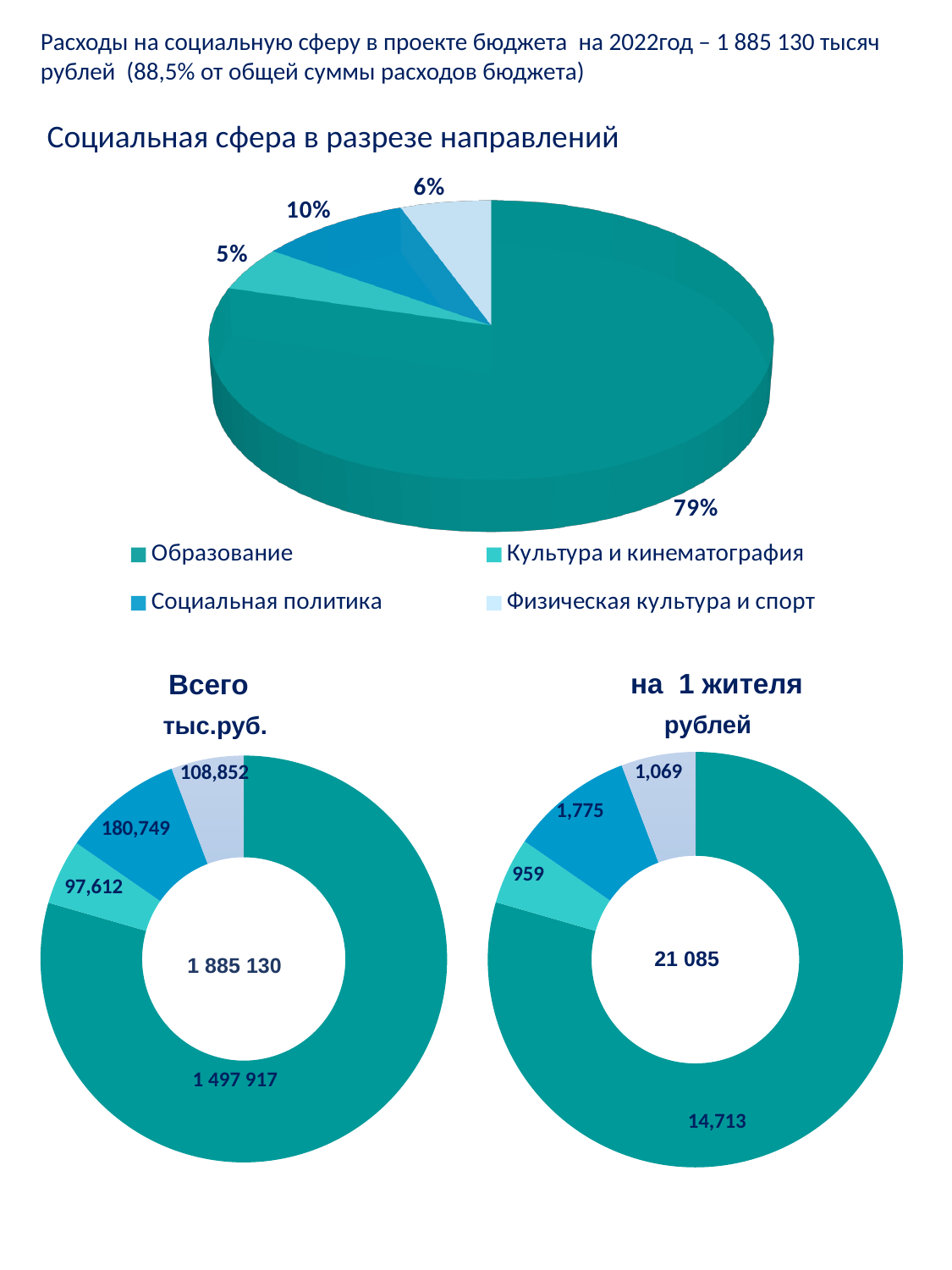
In the donut chart 'Всего тыс.руб.', what is the value of the smallest segment? 97,612 What type of chart is 'Социальная сфера в разрезе направлений'? Pie chart In the pie chart 'Социальная сфера в разрезе направлений', what is the difference in percentage points between Социальная политика and Физическая культура и спорт? 4 percentage points In the donut chart 'на 1 жителя рублей', which is larger: the segment labelled 1,775 or the segment labelled 1,069? 1,775 In the pie chart 'Социальная сфера в разрезе направлений', what share does Образование have? 79% In the donut chart 'на 1 жителя рублей', what total is shown in the centre? 21 085 In the donut chart 'Всего тыс.руб.', what is the value of the largest segment? 1 497 917 How many categories does the legend of the pie chart 'Социальная сфера в разрезе направлений' list? 4 In the pie chart 'Социальная сфера в разрезе направлений', what share does Культура и кинематография have? 5% In the pie chart 'Социальная сфера в разрезе направлений', what share does Социальная политика have? 10% In the donut chart 'Всего тыс.руб.', what total is shown in the centre? 1 885 130 In the pie chart 'Социальная сфера в разрезе направлений', which category has the smallest share? Культура и кинематография